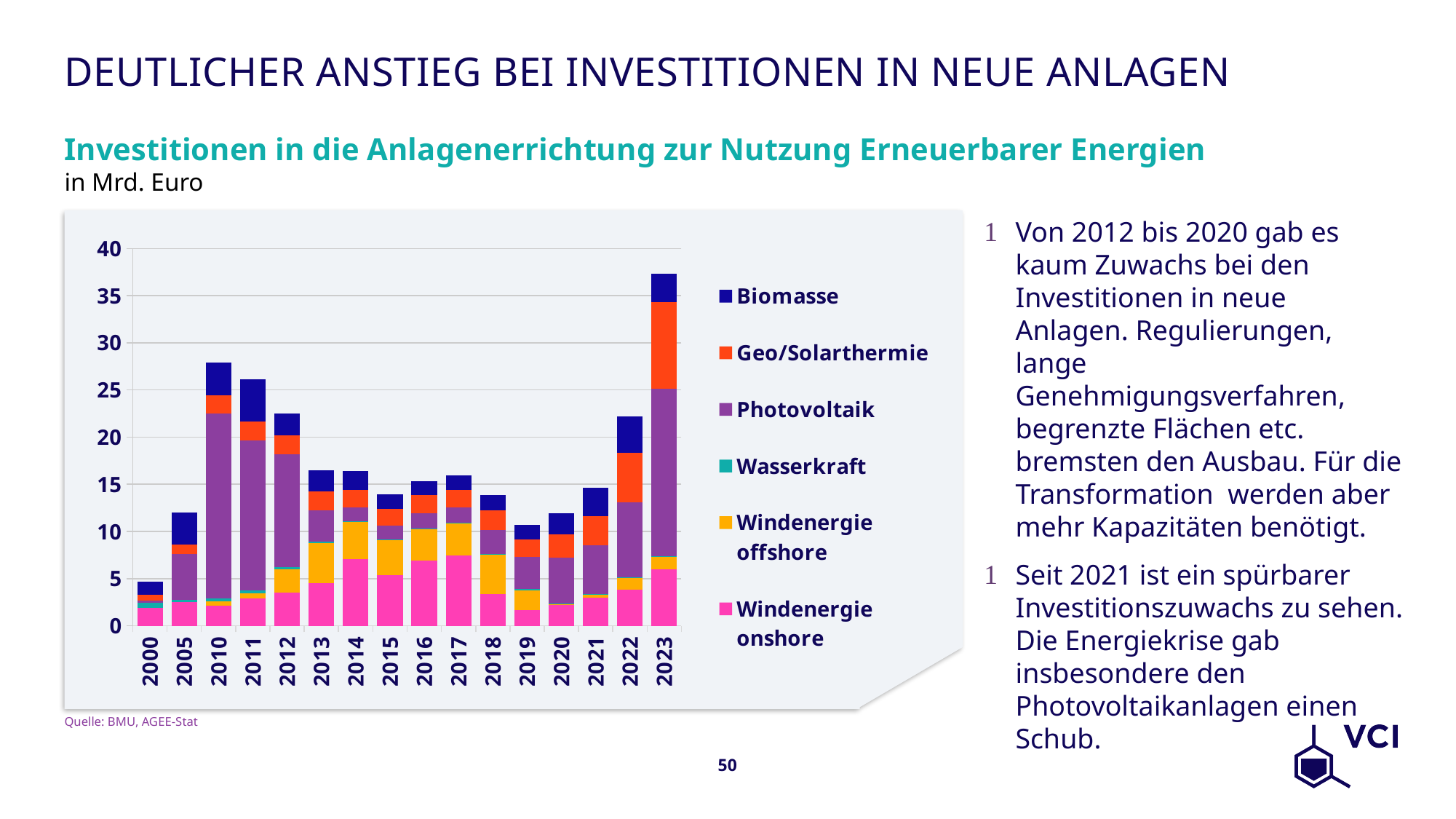
Is the total value for 2023 greater or less than 35? greater Do the total values rise or fall from 2020 to 2023? rise Is the total value for 2010 greater or less than 25? greater How many series does the chart legend list? 6 Which year has the larger total investment, 2010 or 2011? 2010 Which year has the larger total investment, 2012 or 2013? 2012 What kind of chart is shown on the slide? Stacked bar chart Is the total value for 2019 greater or less than 15? less Which series is shown in pink at the bottom of each bar? Windenergie onshore How many years are shown on the x axis of the chart? 16 Which year has the lowest total investment in the chart? 2000 Which year has the highest total investment in the chart? 2023